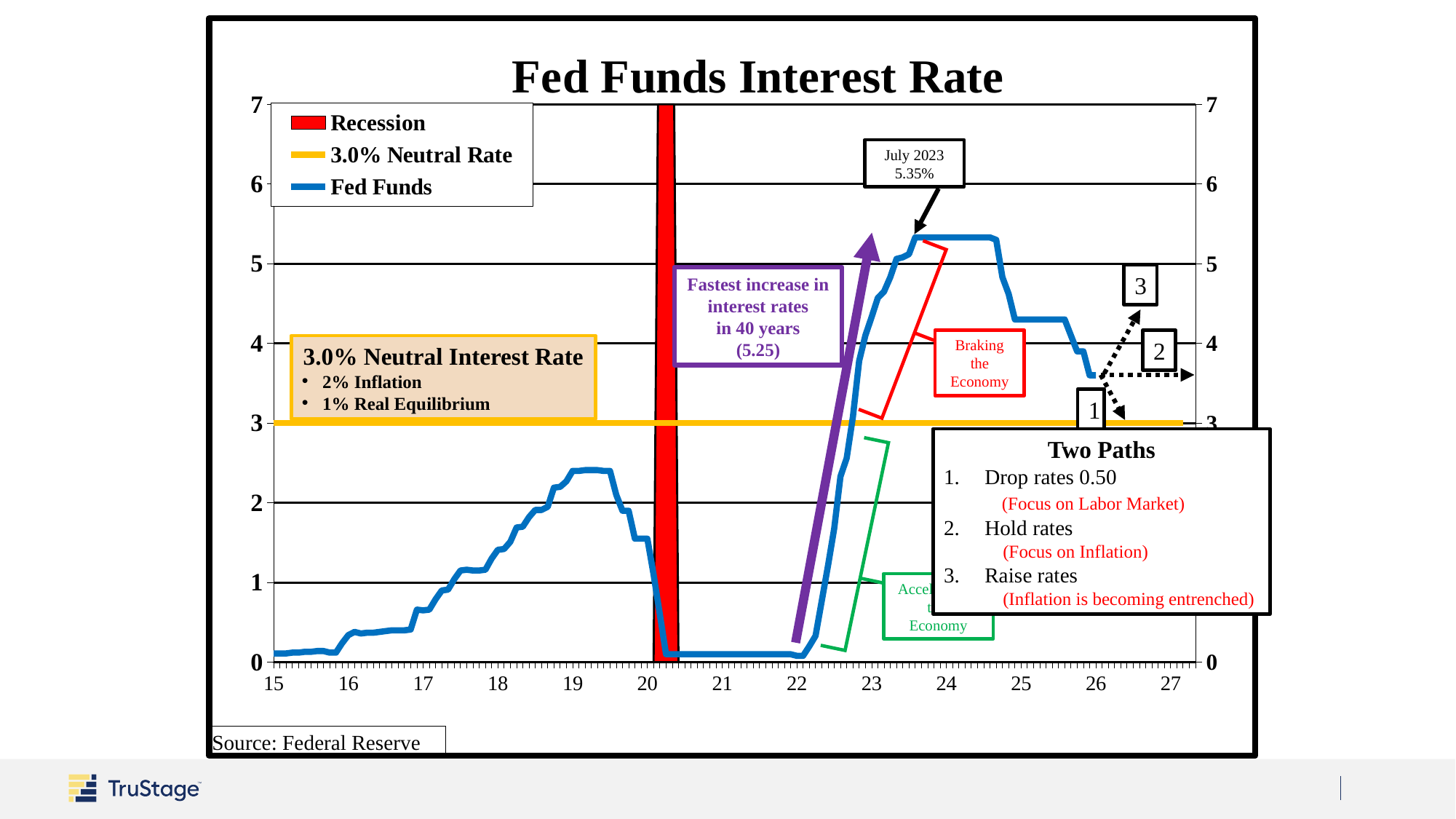
What Fed Funds rate is labelled for July 2023? 5.35% Does the Fed Funds line rise or fall between 24 and 26? fall What is the peak value of the Fed Funds line labelled on the chart? 5.35% Is the Fed Funds value at 21 greater or less than 1? less Is the Fed Funds value at 19 greater or less than 2? greater What is the value of the neutral interest rate line shown on the chart? 3.0% How many entries does the chart legend list? 3 What kind of chart is shown on the slide? line chart Does the Fed Funds line rise or fall between 22 and 23? rise What is the title of the chart? Fed Funds Interest Rate Is the Fed Funds value at 26 greater or less than 3? greater Which is larger, the Fed Funds value at 17 or at 19? 19